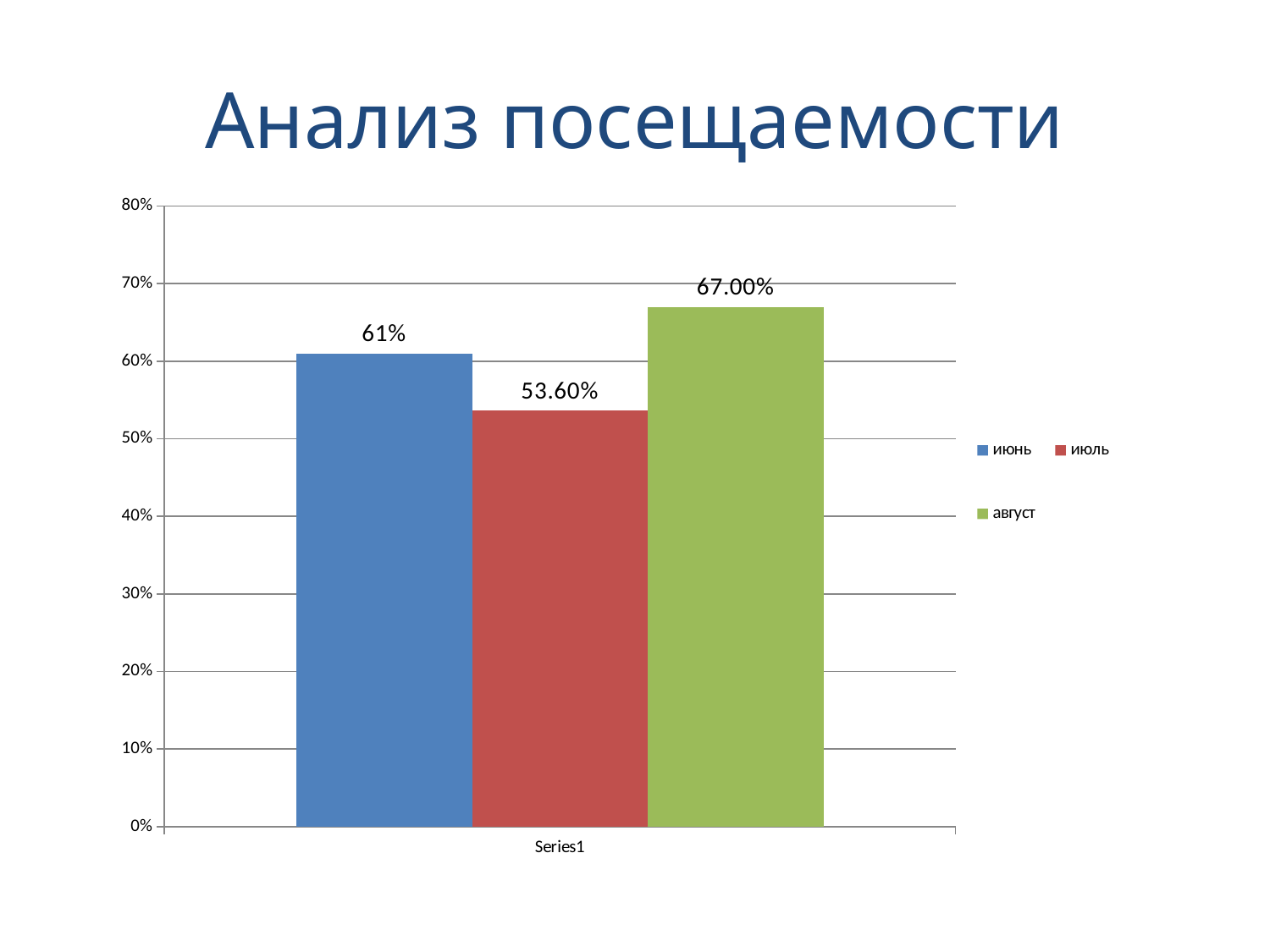
Is the value for июль greater or less than 60%? less What is the difference between the values for август and июнь? 6 percentage points Which month has the lowest value? июль How many series does the legend list? 3 What is the title of the slide? Анализ посещаемости Which month has the highest value? август What is the value shown for июнь? 61% What kind of chart is shown on the slide? bar chart Which is larger, the value for июнь or the value for июль? июнь What is the value shown for август? 67.00% What is the difference between the values for июнь and июль? 7.4 percentage points What is the value shown for июль? 53.60%